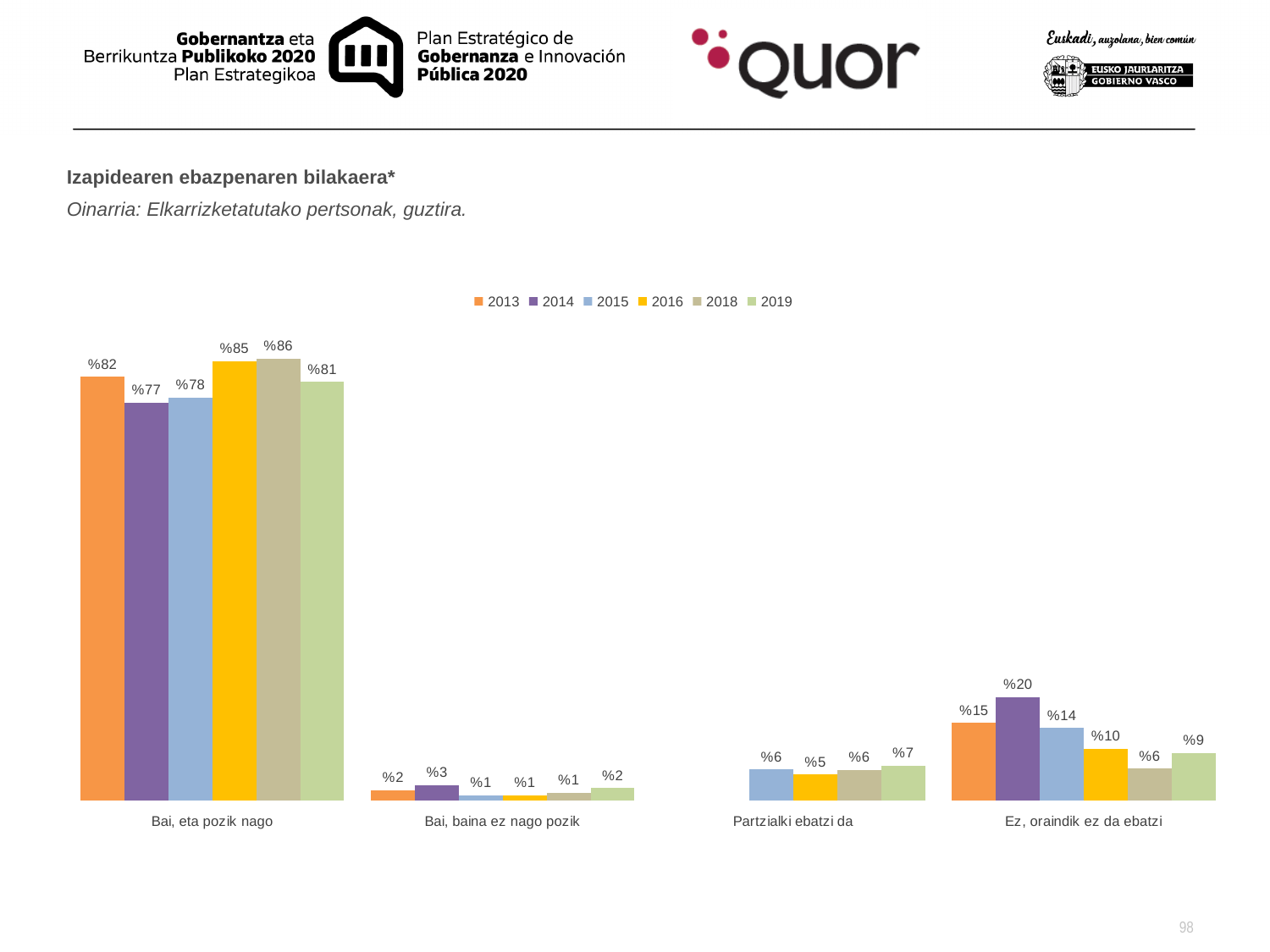
Which category has the highest values overall? Bai, eta pozik nago What is the difference between the 2018 and 2014 values in the "Bai, eta pozik nago" category? 9 percentage points What is the difference between the 2014 and 2016 values in the "Ez, oraindik ez da ebatzi" category? 10 percentage points What is the value for 2018 in the "Bai, eta pozik nago" category? %86 What is the value for 2019 in the "Partzialki ebatzi da" category? %7 In the "Ez, oraindik ez da ebatzi" category, which is larger: the 2013 value or the 2015 value? 2013 What kind of chart is shown on the slide? Bar chart Which year has the highest value in the "Bai, eta pozik nago" category? 2018 How many series does the legend list? 6 Which year has the lowest value in the "Ez, oraindik ez da ebatzi" category? 2018 How many categories are shown on the x axis? 4 What is the value for 2014 in the "Ez, oraindik ez da ebatzi" category? %20